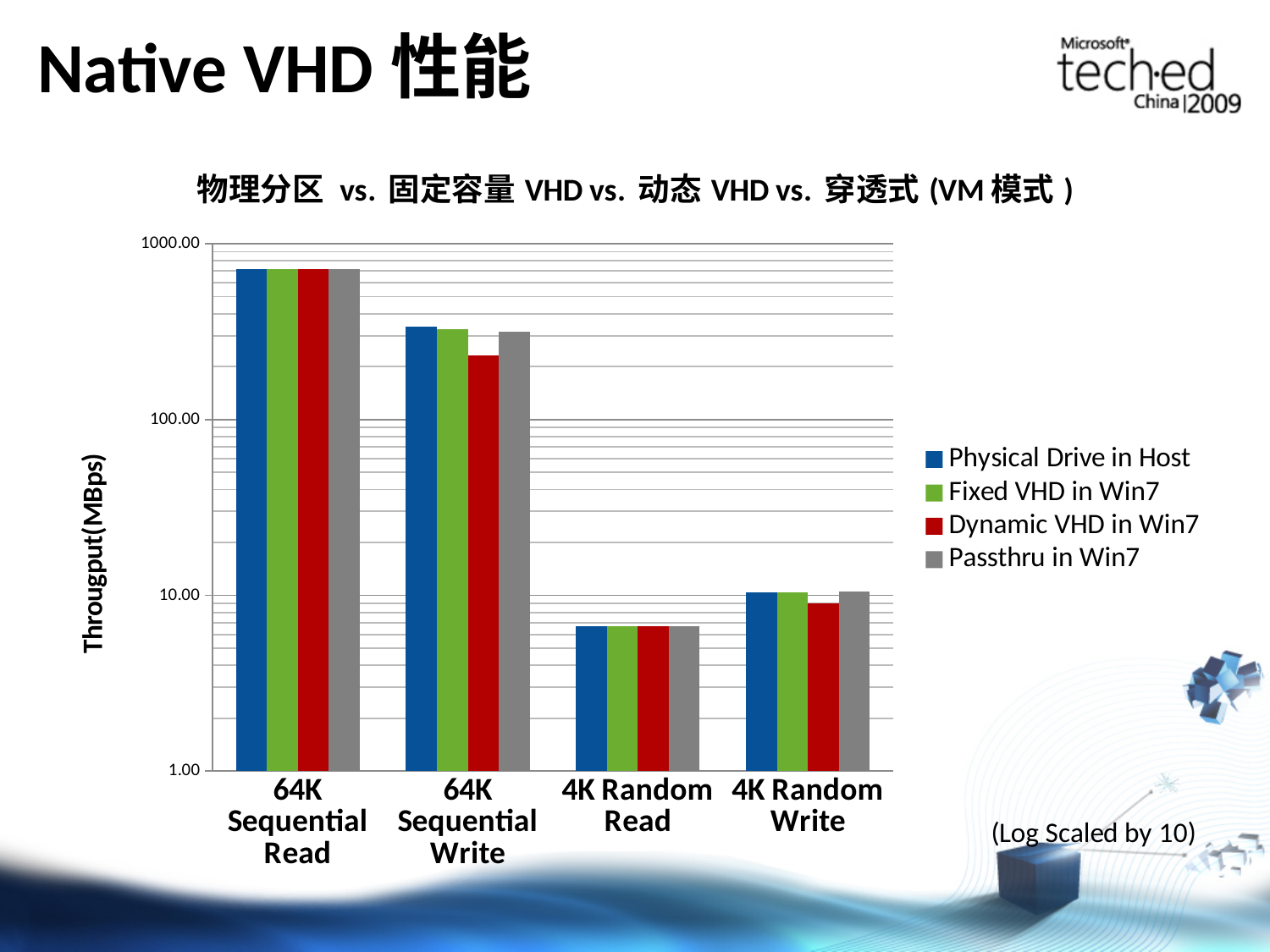
At 4K Random Write, which is larger: Fixed VHD in Win7 or Dynamic VHD in Win7? Fixed VHD in Win7 How many categories are shown on the x axis of the chart? 4 Is the value for Dynamic VHD in Win7 at 64K Sequential Write greater or less than 100? greater Is the value for Physical Drive in Host at 4K Random Read greater or less than 10? less Is the value for Passthru in Win7 at 4K Random Write greater or less than 100? less At 64K Sequential Write, which is larger: Physical Drive in Host or Dynamic VHD in Win7? Physical Drive in Host For Physical Drive in Host, which category has the lowest throughput? 4K Random Read What is the label on the chart's y axis? Througput(MBps) What kind of chart is shown on the slide? bar chart How many series does the chart's legend list? 4 For Physical Drive in Host, which category has the highest throughput? 64K Sequential Read